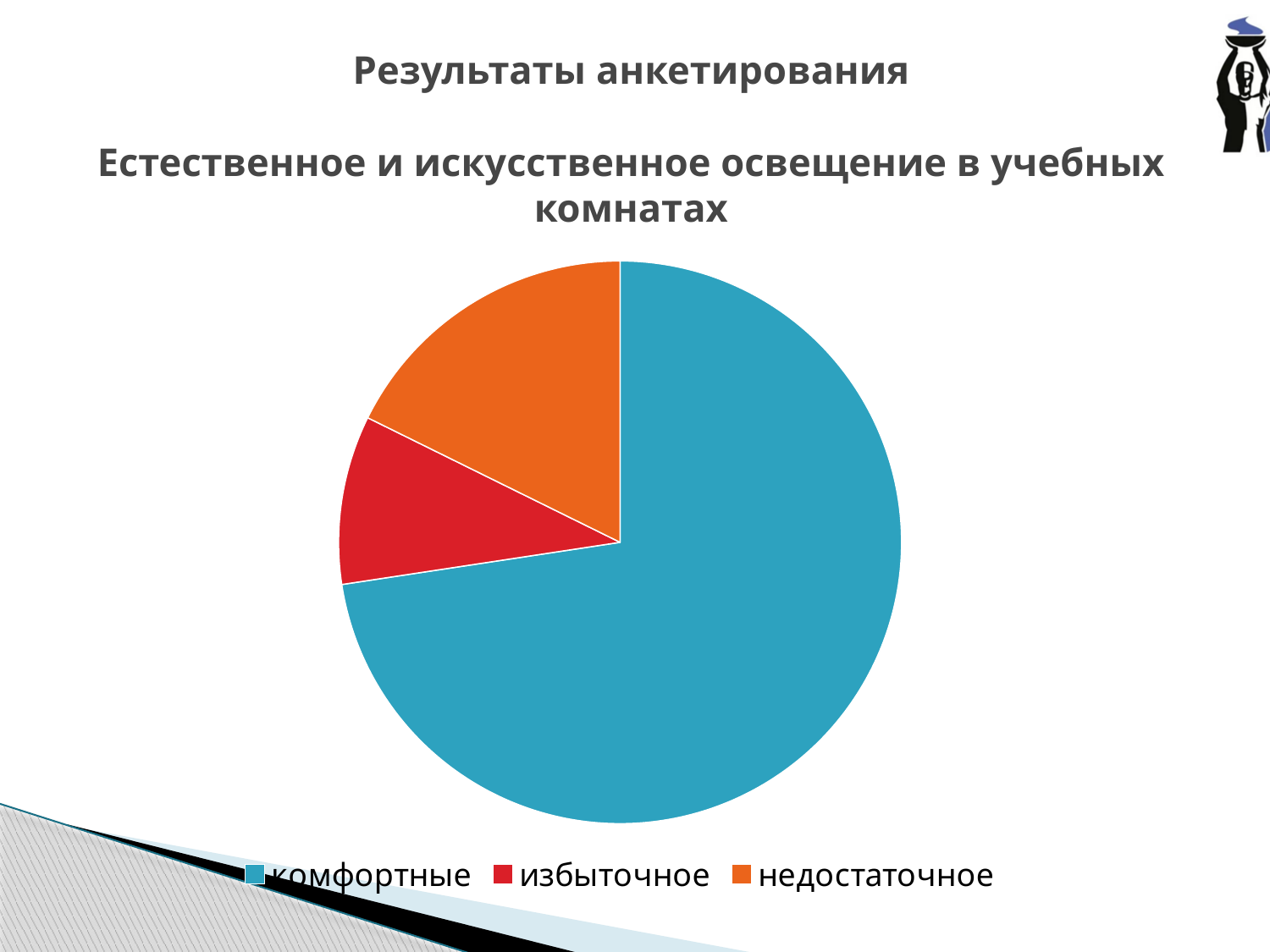
How many slices does the pie chart have? 3 How many entries does the legend list? 3 Which slice is larger: комфортные or недостаточное? комфортные Which category has the largest slice of the pie chart? комфортные What colour is the slice for избыточное? red Which slice is larger: недостаточное or избыточное? недостаточное What kind of chart is shown on the slide? pie chart Does the комфортные slice take up more or less than half of the pie? more Which category has the smallest slice of the pie chart? избыточное What is the title of the chart? Естественное и искусственное освещение в учебных комнатах